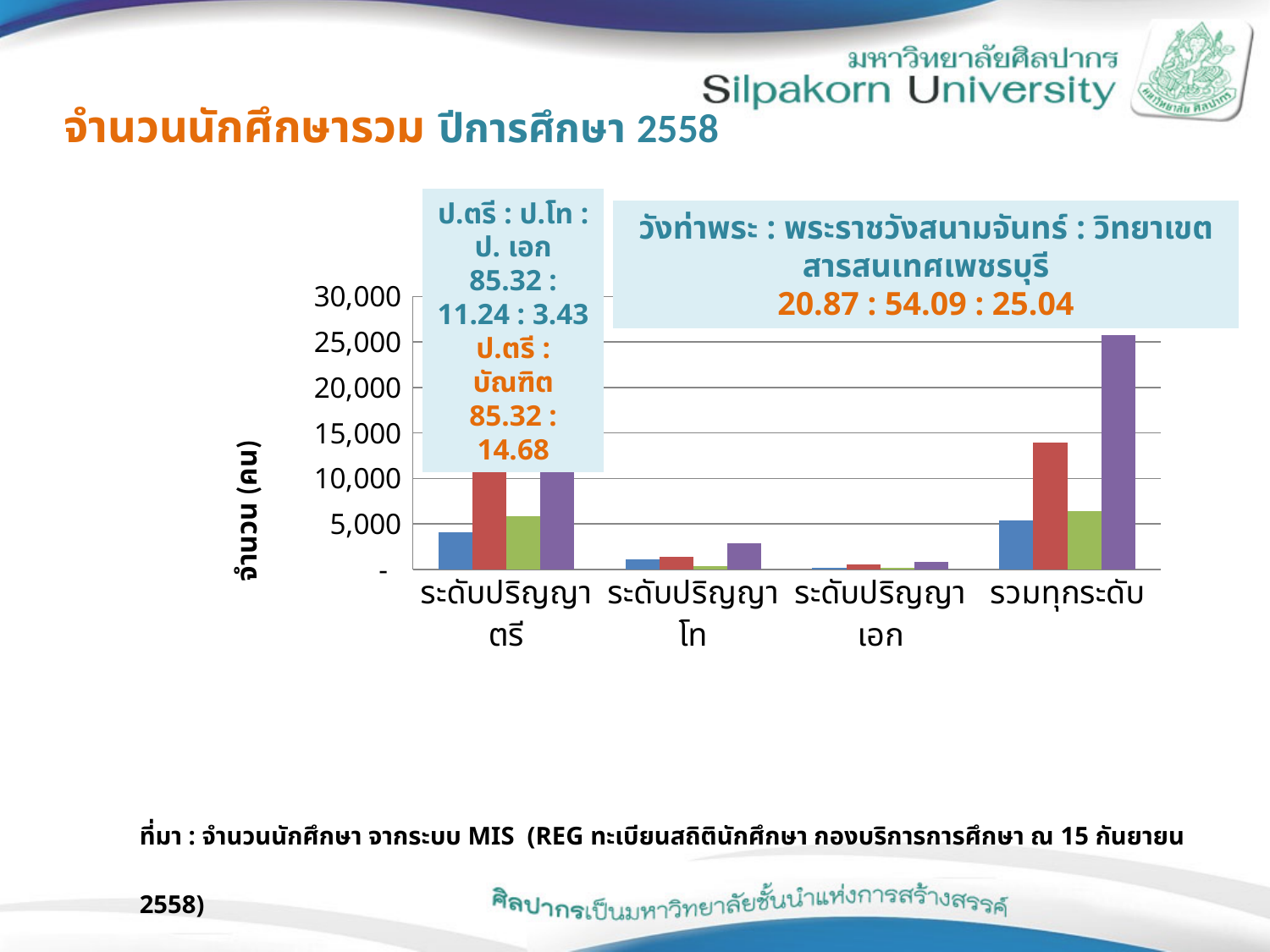
In the รวมทุกระดับ category, which is larger: the red bar or the green bar? the red bar Is the value of the blue bar for ระดับปริญญาตรี greater or less than 5,000? less What kind of chart is shown on the slide? bar chart Is the value of the purple bar for ระดับปริญญาโท greater or less than 5,000? less Is the value of the purple bar for รวมทุกระดับ greater or less than 20,000? greater Which category has the smallest bars overall in the chart? ระดับปริญญาเอก How many categories are shown on the x axis of the chart? 4 How many bars are plotted for each category in the chart? 4 What is the label on the vertical axis of the chart? จำนวน (คน) Which category contains the tallest bar in the chart? รวมทุกระดับ Which is larger: the purple bar for ระดับปริญญาโท or the purple bar for ระดับปริญญาเอก? ระดับปริญญาโท